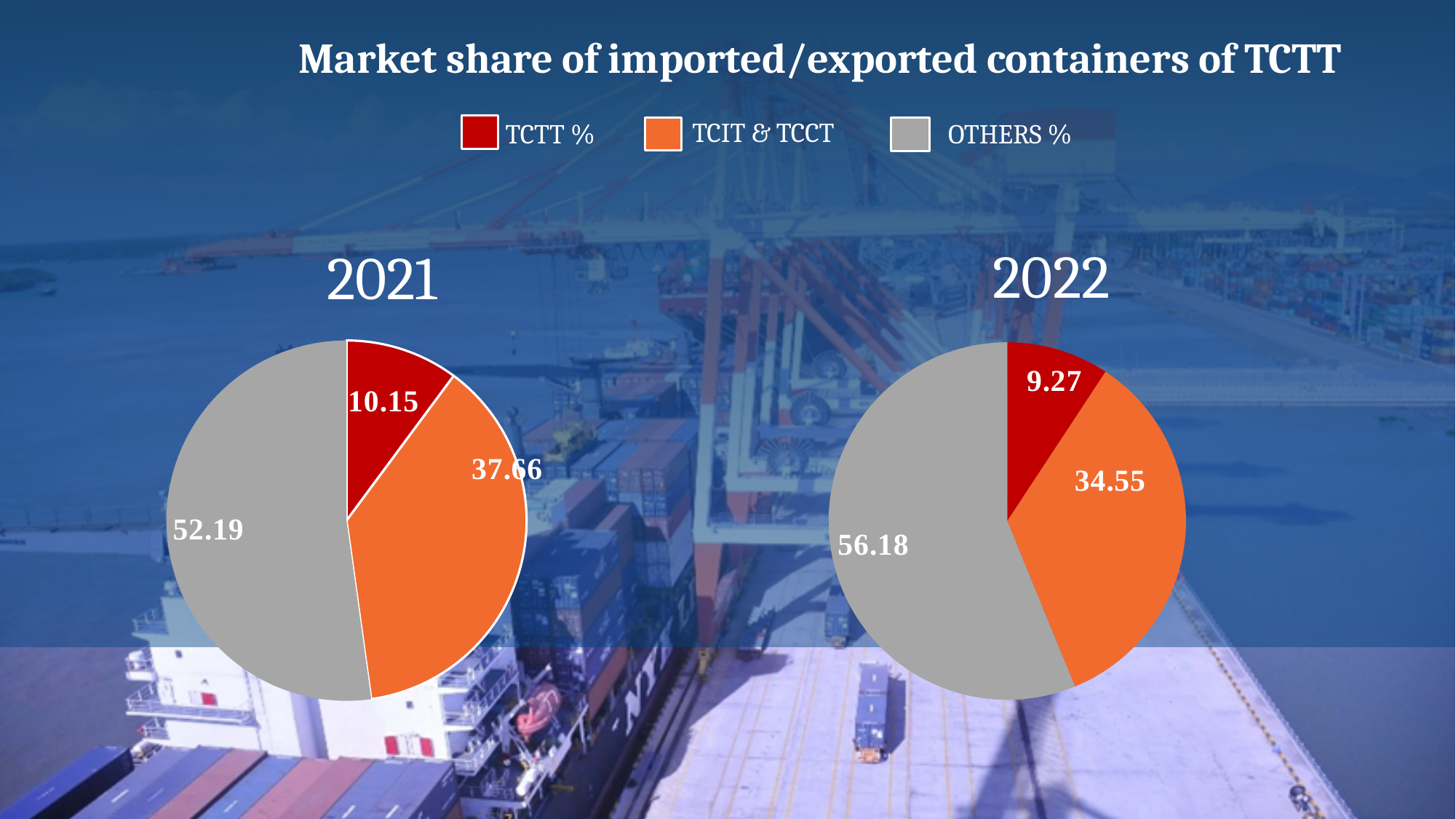
In the 2022 pie chart, what is the value for OTHERS %? 56.18 What is the title of the slide's charts? Market share of imported/exported containers of TCTT In the 2022 pie chart, what is the value for TCTT %? 9.27 What type of chart is used to show the 2021 data? Pie chart In the 2021 pie chart, what is the value for TCTT %? 10.15 Is the OTHERS % value larger in the 2021 pie chart or the 2022 pie chart? 2022 What is the difference between the TCIT & TCCT value in 2021 and in 2022? 3.11 In the 2021 pie chart, what is the value for TCIT & TCCT? 37.66 How many series does the legend list? 3 In the 2022 pie chart, which category has the smallest slice? TCTT % How many slices does the 2022 pie chart have? 3 In the 2021 pie chart, which category has the largest slice? OTHERS %